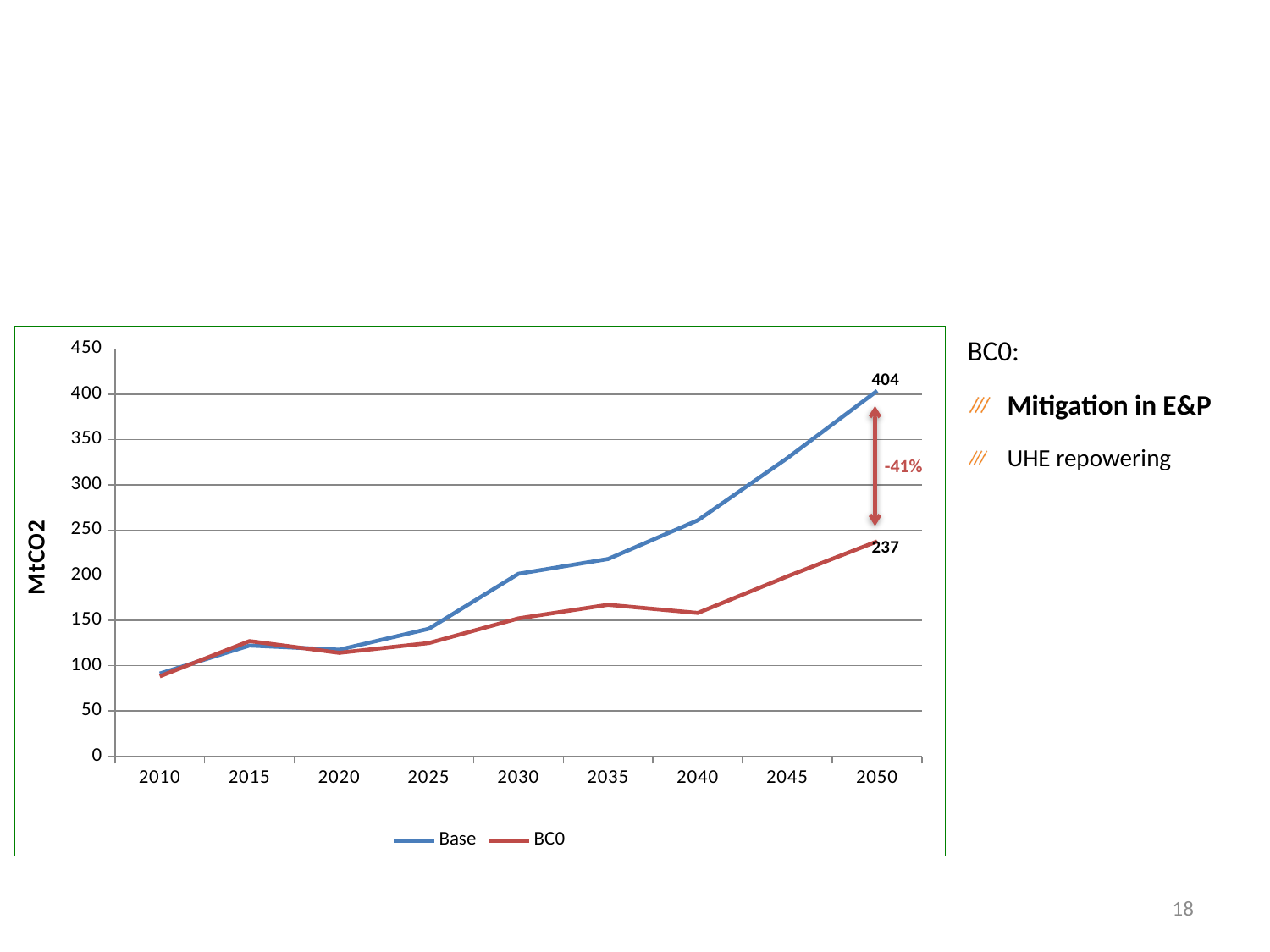
How many series does the legend list? 2 Which series has the higher value in 2050, Base or BC0? Base Does the Base series rise or fall between 2025 and 2050? Rise What is the value of the Base series in 2050? 404 What is the value of the BC0 series in 2050? 237 What kind of chart is shown? Line chart Is the value for Base in 2010 greater or less than 100? less What is the difference between the Base and BC0 values in 2050? 167 Is the value for BC0 in 2030 greater or less than 200? less Is the value for Base in 2040 greater or less than 200? greater What is the label on the y axis? MtCO2 How many years are labelled on the x axis? 9